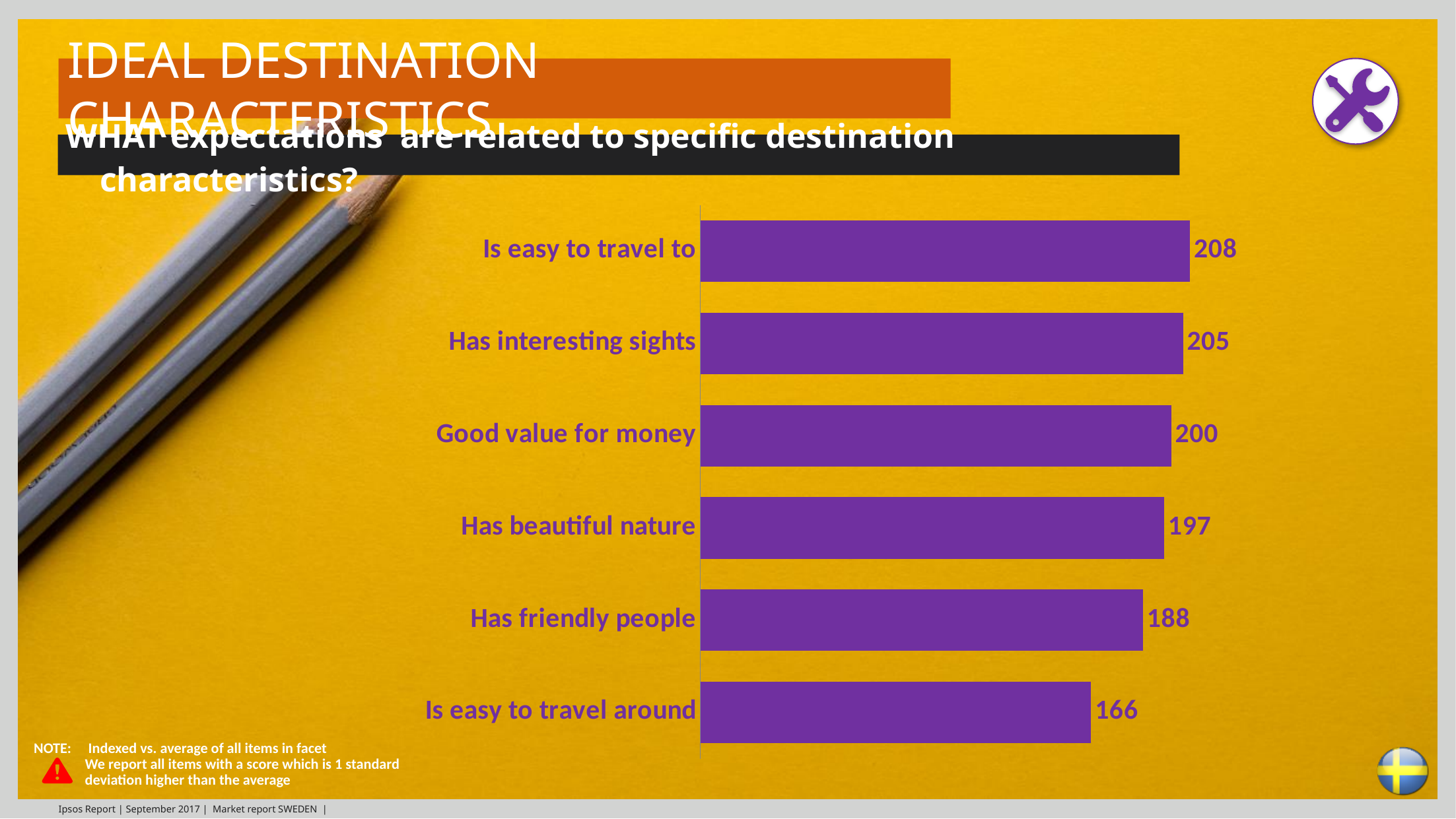
What is the value for "Has beautiful nature"? 197 How many categories are shown in the chart? 6 What is the difference between the values for "Is easy to travel to" and "Is easy to travel around"? 42 Which is larger, the value for "Has friendly people" or the value for "Has beautiful nature"? Has beautiful nature Which category has the lowest value? Is easy to travel around What is the value for "Good value for money"? 200 What is the value for "Has interesting sights"? 205 Which category has the highest value? Is easy to travel to What is the value for "Is easy to travel to"? 208 What kind of chart is shown on the slide? Bar chart What is the value for "Has friendly people"? 188 What is the value for "Is easy to travel around"? 166